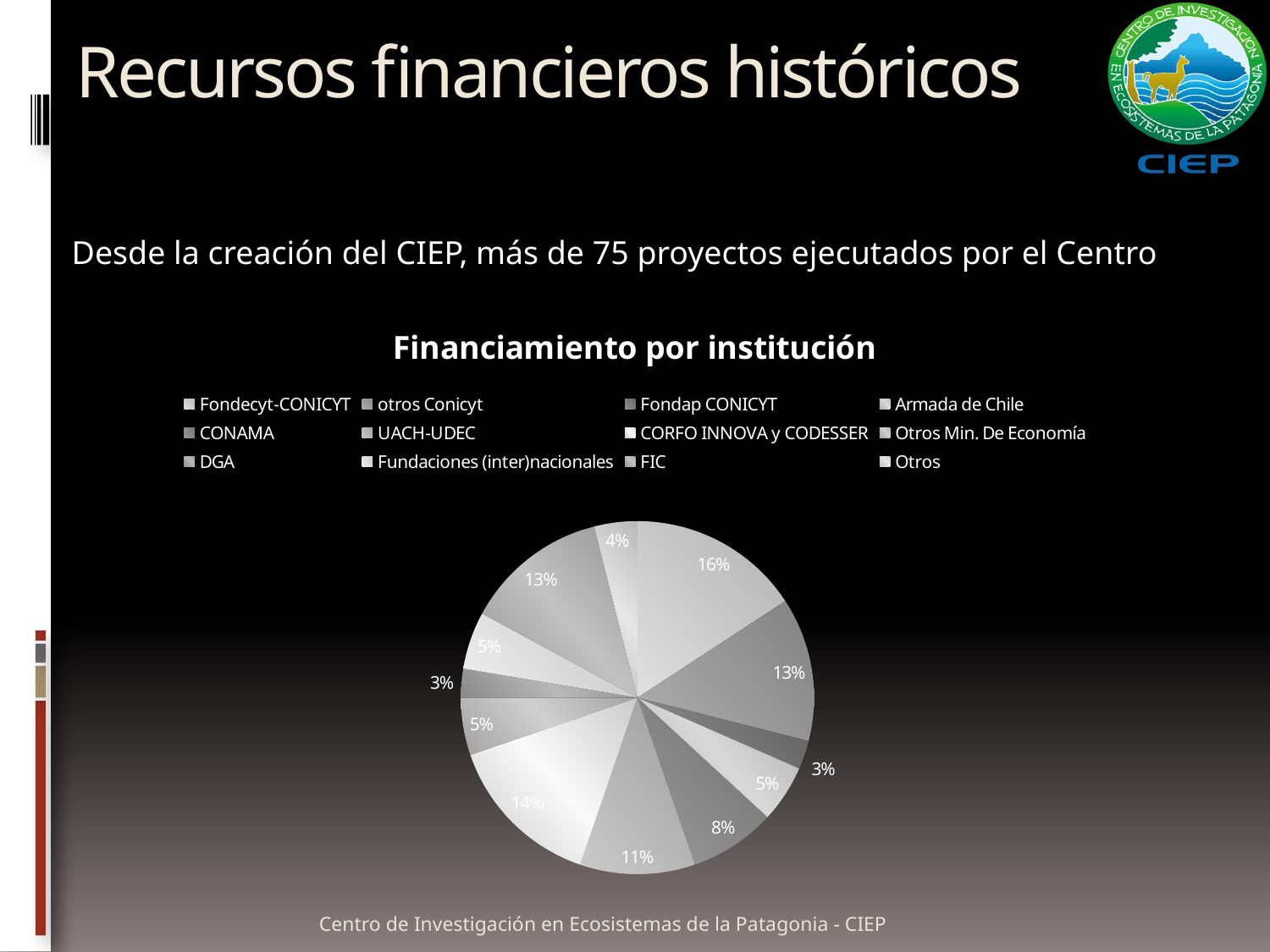
What is the share of the largest slice in the pie chart? 16% How many slices in the pie chart are labelled 13%? 2 How many slices in the pie chart are labelled 3%? 2 What is the share of the smallest slice in the pie chart? 3% What is the title of the chart? Financiamiento por institución How many entries does the chart's legend list? 12 What is the difference between the largest slice (16%) and the smallest slice (3%) in the pie chart? 13 percentage points Which entry is listed first in the chart's legend? Fondecyt-CONICYT How many slices does the pie chart have? 12 What is the share of the slice at the bottom of the pie chart? 11% What kind of chart is shown on the slide? Pie chart